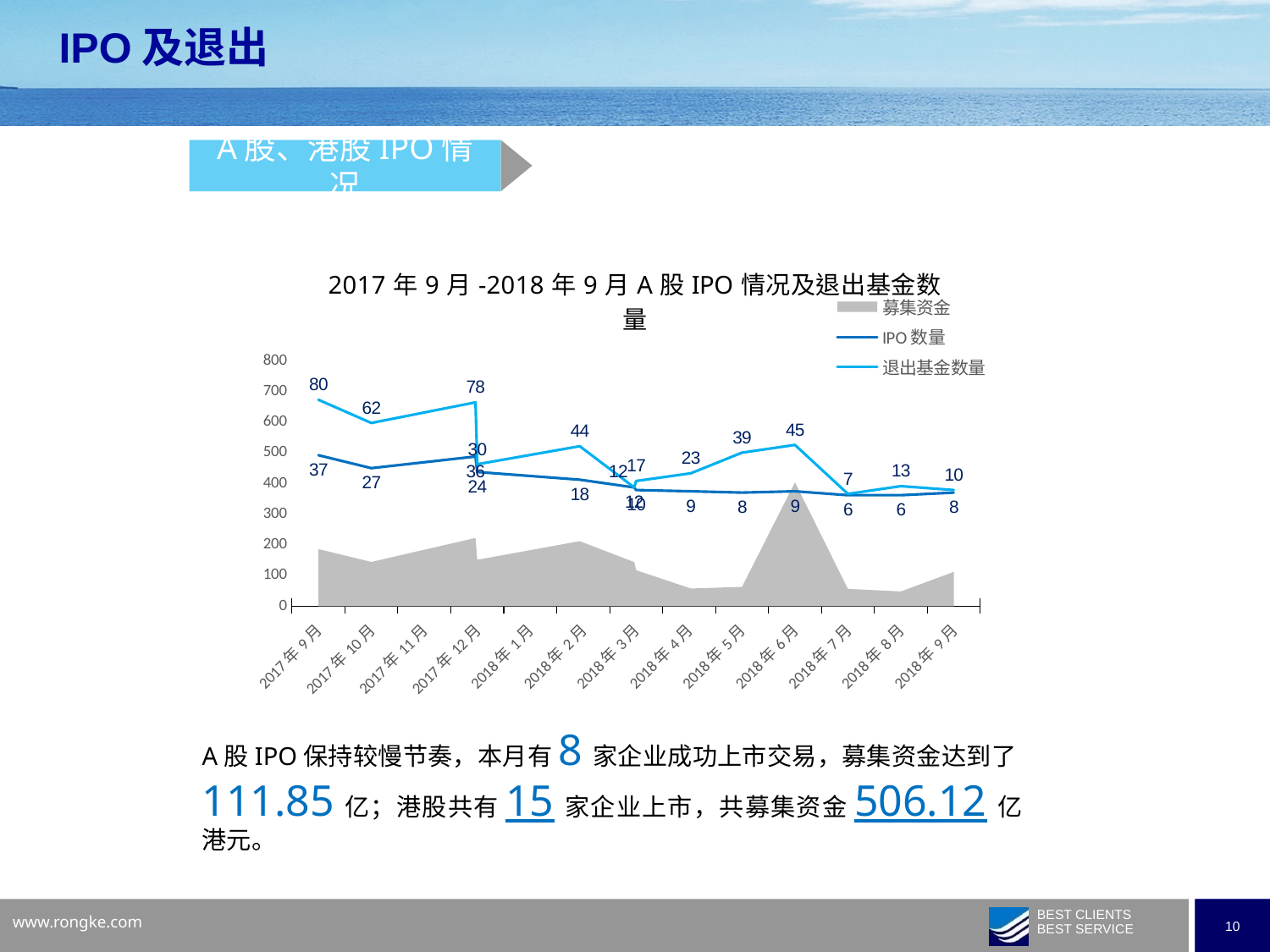
What is the IPO数量 value for 2017年10月? 27 How many months are shown on the x axis? 13 What is the IPO数量 value for 2018年9月? 8 What is the 退出基金数量 value for 2017年9月? 80 Which is larger, the 退出基金数量 value for 2018年5月 or for 2018年6月? 2018年6月 Does the IPO数量 series generally rise or fall from 2017年9月 to 2018年9月? fall In which month is the 退出基金数量 series highest? 2017年9月 In which month is the 退出基金数量 series lowest? 2018年7月 What is the 退出基金数量 value for 2018年6月? 45 Is the 募集资金 value for 2018年6月 greater or less than 300? greater How many series does the legend list? 3 What is the difference between 退出基金数量 and IPO数量 in 2017年9月? 43